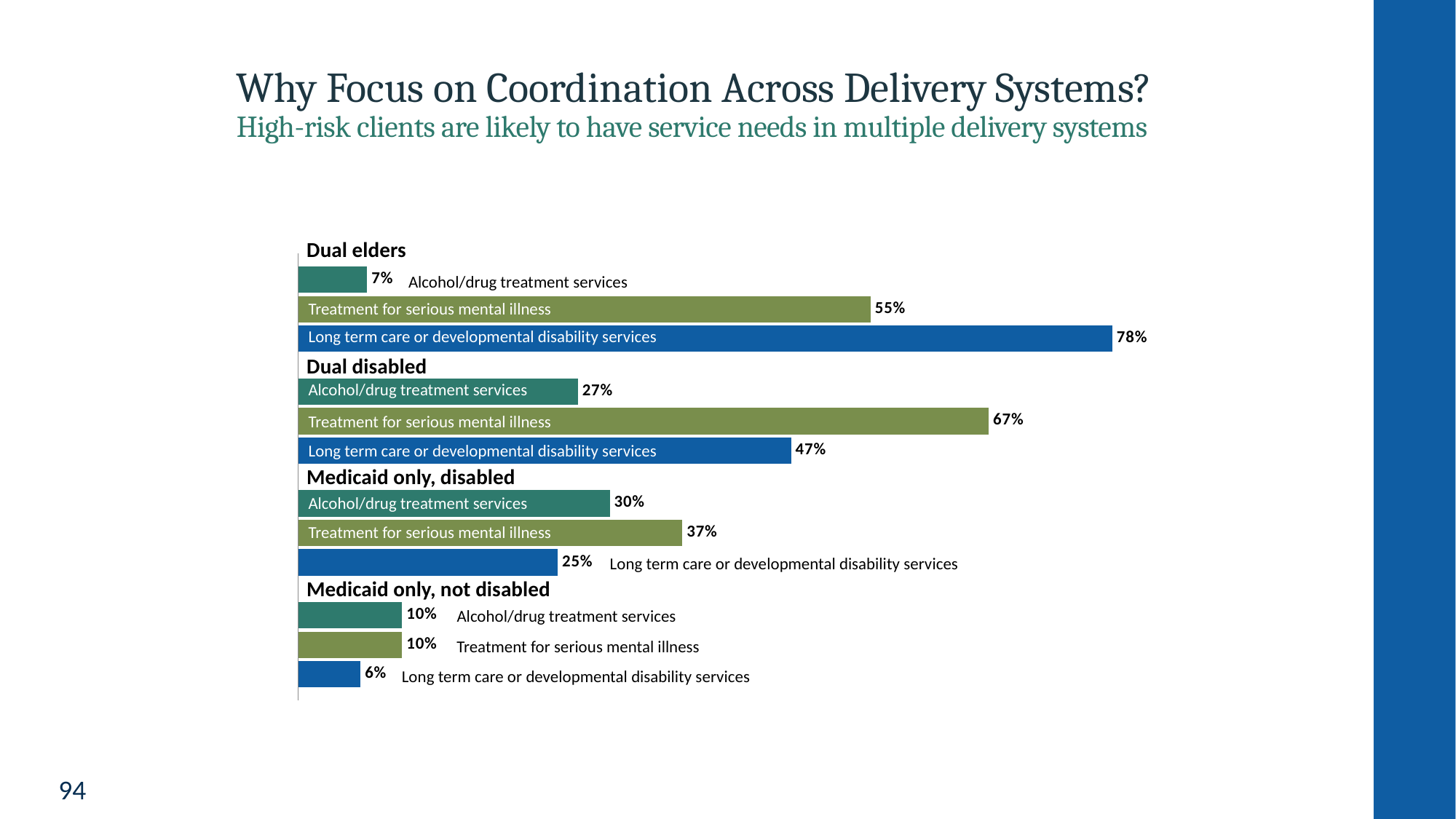
Which group and service has the lowest percentage on the chart? Medicaid only, not disabled, Long term care or developmental disability services Which group and service has the highest percentage on the chart? Dual elders, Long term care or developmental disability services How many client groups are shown on the chart? 4 How many bars are plotted on the chart in total? 12 What is the difference between the Dual disabled and Dual elders percentages for treatment for serious mental illness? 12% What percentage of Dual elders use long term care or developmental disability services? 78% Which group has the higher percentage for alcohol/drug treatment services: Dual elders or Medicaid only, disabled? Medicaid only, disabled What percentage of Medicaid only, not disabled clients use long term care or developmental disability services? 6% What percentage of Medicaid only, disabled clients receive treatment for serious mental illness? 37% What percentage of Dual disabled clients use alcohol/drug treatment services? 27% Which is larger for Dual disabled clients: treatment for serious mental illness or long term care or developmental disability services? Treatment for serious mental illness What type of chart is shown on the slide? Bar chart